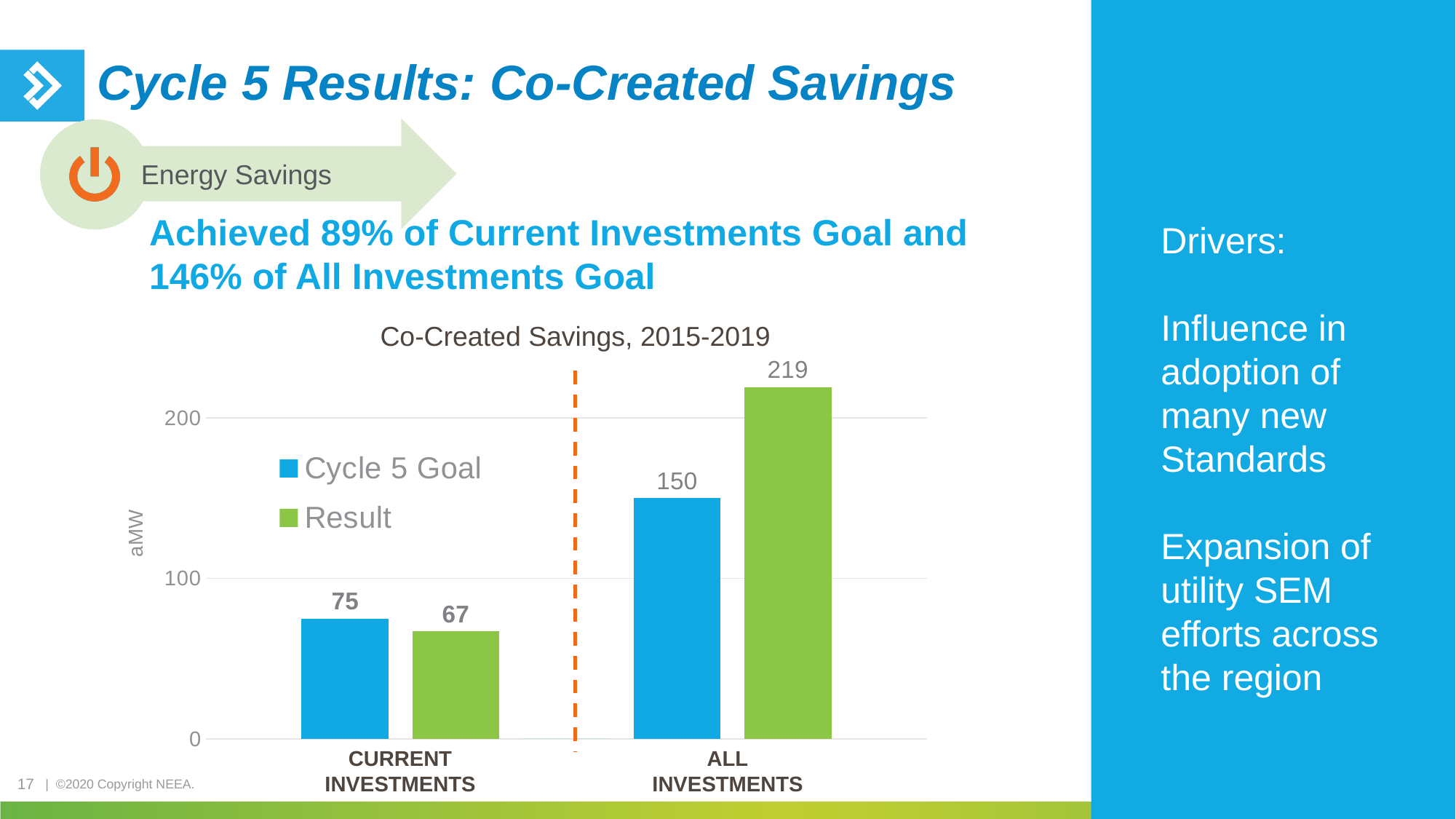
Which bar has the lowest value in the chart? Result for Current Investments For Current Investments, which is larger: the Cycle 5 Goal or the Result? Cycle 5 Goal What is the Result value for Current Investments? 67 What is the difference between the Result and the Cycle 5 Goal for All Investments? 69 Which bar has the highest value in the chart? Result for All Investments What is the Cycle 5 Goal value for All Investments? 150 What is the Result value for All Investments? 219 What is the Cycle 5 Goal value for Current Investments? 75 How many series does the legend list? 2 What is the title of the chart? Co-Created Savings, 2015-2019 What is the difference between the Cycle 5 Goal and the Result for Current Investments? 8 What kind of chart is shown on the slide? Bar chart